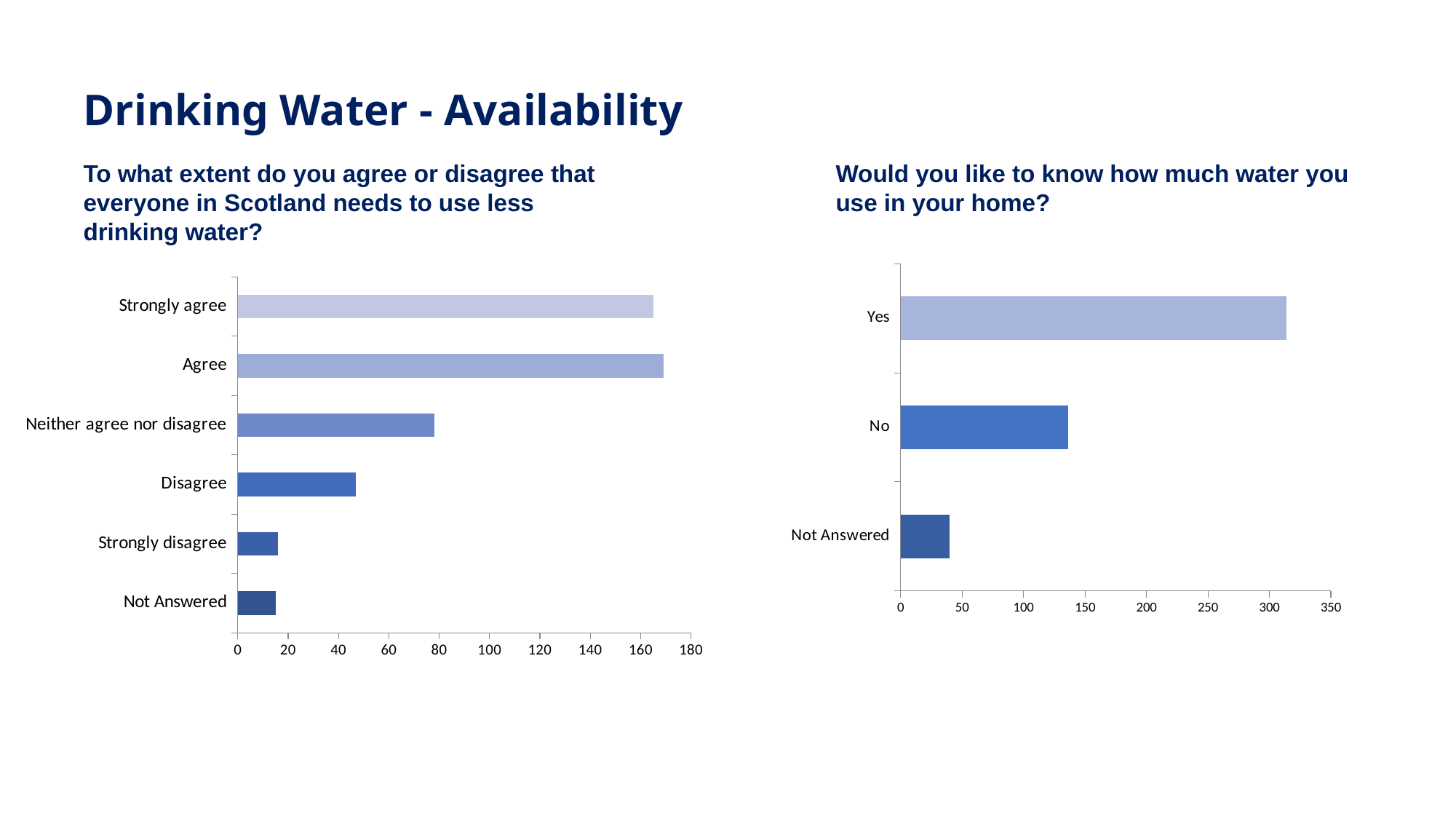
In the left chart, is the value for Strongly agree greater or less than 140? greater In the left chart, which is larger, the value for Agree or the value for Disagree? Agree In the left chart, is the value for Disagree greater or less than 60? less In the right chart, is the value for No greater or less than 150? less In the right chart (Would you like to know how much water you use in your home?), which category has the highest value? Yes How many categories does the right chart (Would you like to know how much water you use in your home?) show? 3 What type of chart is used on the left chart about using less drinking water? bar chart In the right chart (Would you like to know how much water you use in your home?), which category has the lowest value? Not Answered How many categories does the left chart (agree or disagree about using less drinking water) show? 6